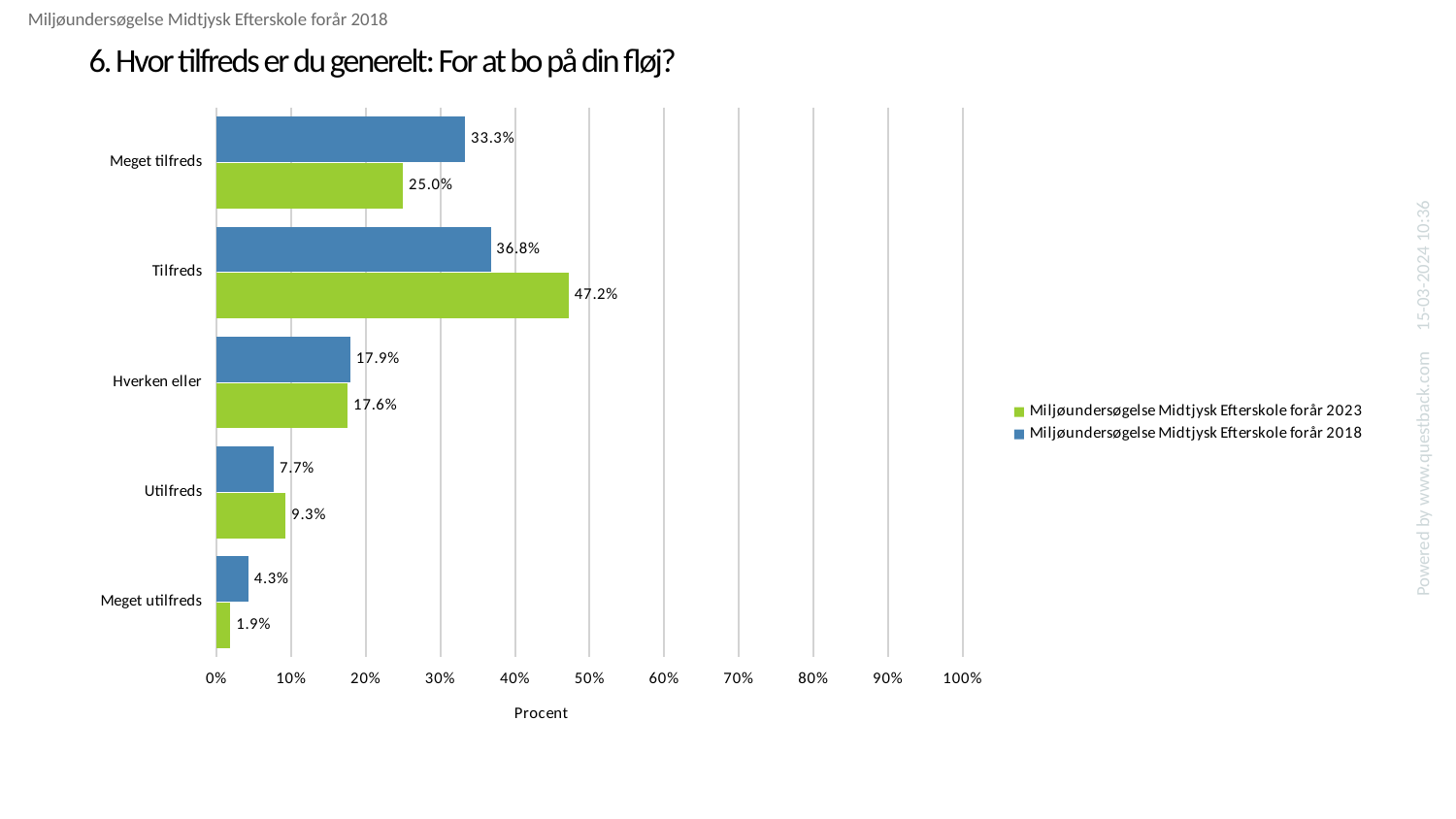
What is the difference between the 2018 and 2023 values for Meget tilfreds? 8.3% What is the value for Meget tilfreds in the Miljøundersøgelse Midtjysk Efterskole forår 2018 series? 33.3% Is the 2023 value for Tilfreds greater or less than 40%? greater How many series does the legend list? 2 What is the difference between the 2023 and 2018 values for Tilfreds? 10.4% Which category has the highest value in the Miljøundersøgelse Midtjysk Efterskole forår 2018 series? Tilfreds Which category has the lowest value in the Miljøundersøgelse Midtjysk Efterskole forår 2023 series? Meget utilfreds What kind of chart is shown on the slide? Bar chart What is the value for Meget utilfreds in the Miljøundersøgelse Midtjysk Efterskole forår 2023 series? 1.9% What is the value for Tilfreds in the Miljøundersøgelse Midtjysk Efterskole forår 2023 series? 47.2% How many categories are shown on the chart? 5 For Utilfreds, which series has the larger value, 2018 or 2023? 2023